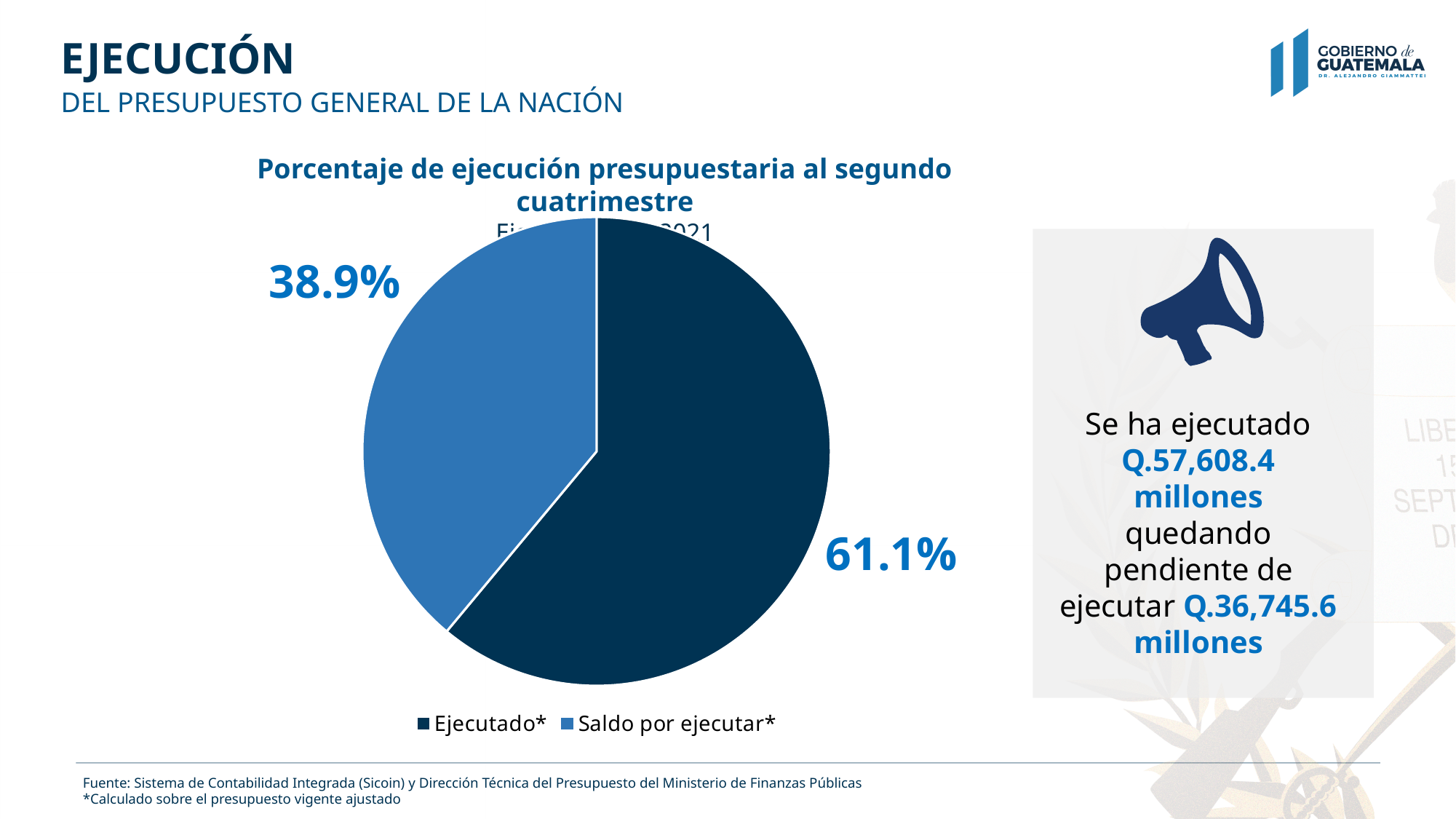
How many entries does the legend of the pie chart list? 2 Which legend entry is shown in the lighter blue colour? Saldo por ejecutar* How many slices does the pie chart have? 2 What is the difference in percentage points between the Ejecutado* slice and the Saldo por ejecutar* slice? 22.2 What percentage of the pie chart is labelled Saldo por ejecutar*? 38.9% What kind of chart is shown on the slide? Pie chart Which slice of the pie chart is the largest? Ejecutado* What is the title of the chart on the slide? Porcentaje de ejecución presupuestaria al segundo cuatrimestre What share of the pie does the Saldo por ejecutar* slice represent? 38.9% What percentage of the pie chart is labelled Ejecutado*? 61.1% Which is larger in the pie chart, Ejecutado* or Saldo por ejecutar*? Ejecutado* Which slice of the pie chart is the smallest? Saldo por ejecutar*